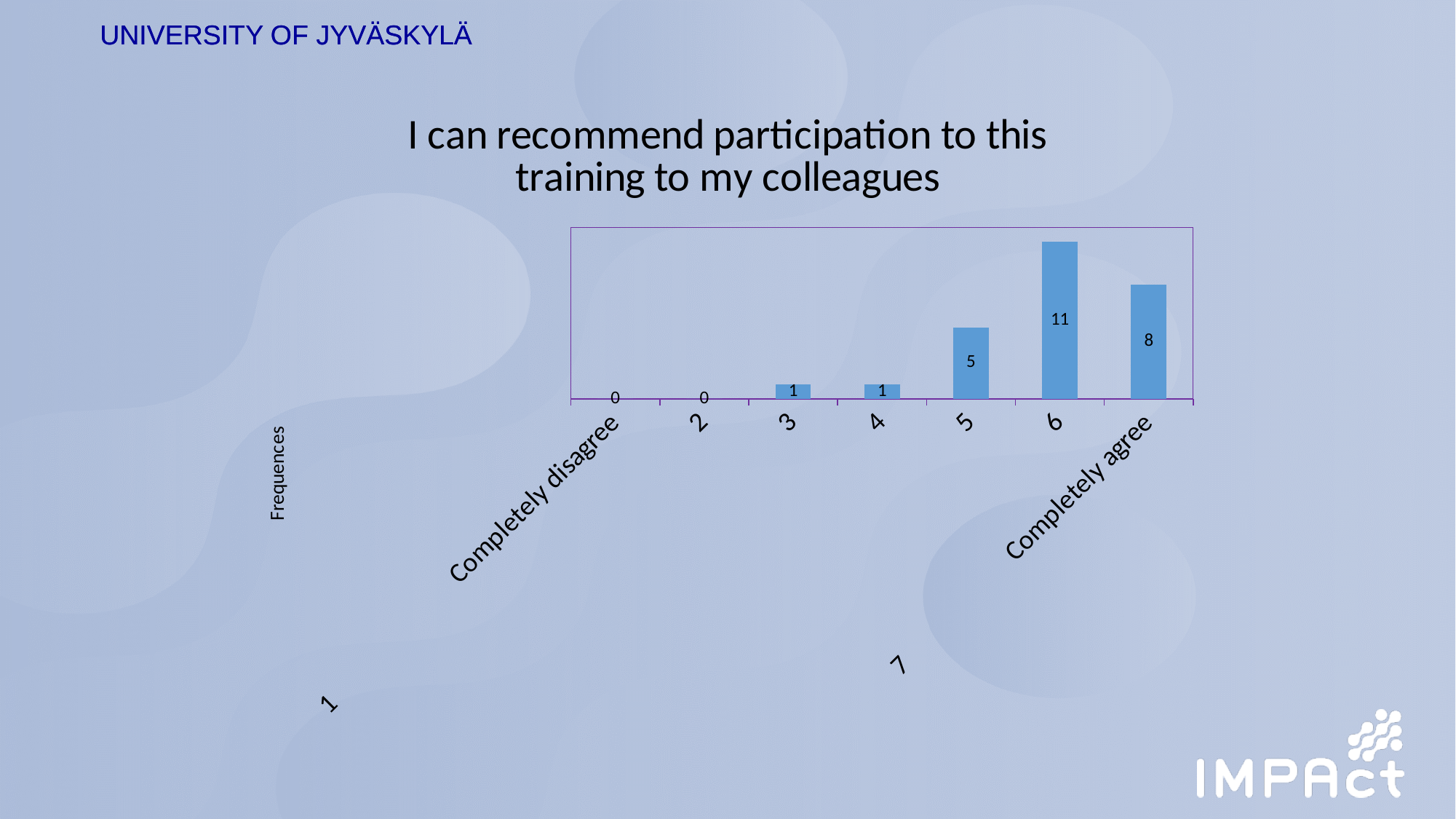
What is the title of the chart? I can recommend participation to this training to my colleagues What is the value for category 3? 1 What is the label of the vertical axis? Frequences What is the value for category 5? 5 How many categories are shown on the x axis? 7 What is the value for "Completely disagree"? 0 Which is larger, the value for category 5 or the value for "Completely agree"? Completely agree What is the difference between the values for category 6 and "Completely agree"? 3 What is the value for "Completely agree"? 8 Which category has the highest value? 6 What type of chart is shown on the slide? bar chart What is the value for category 6? 11